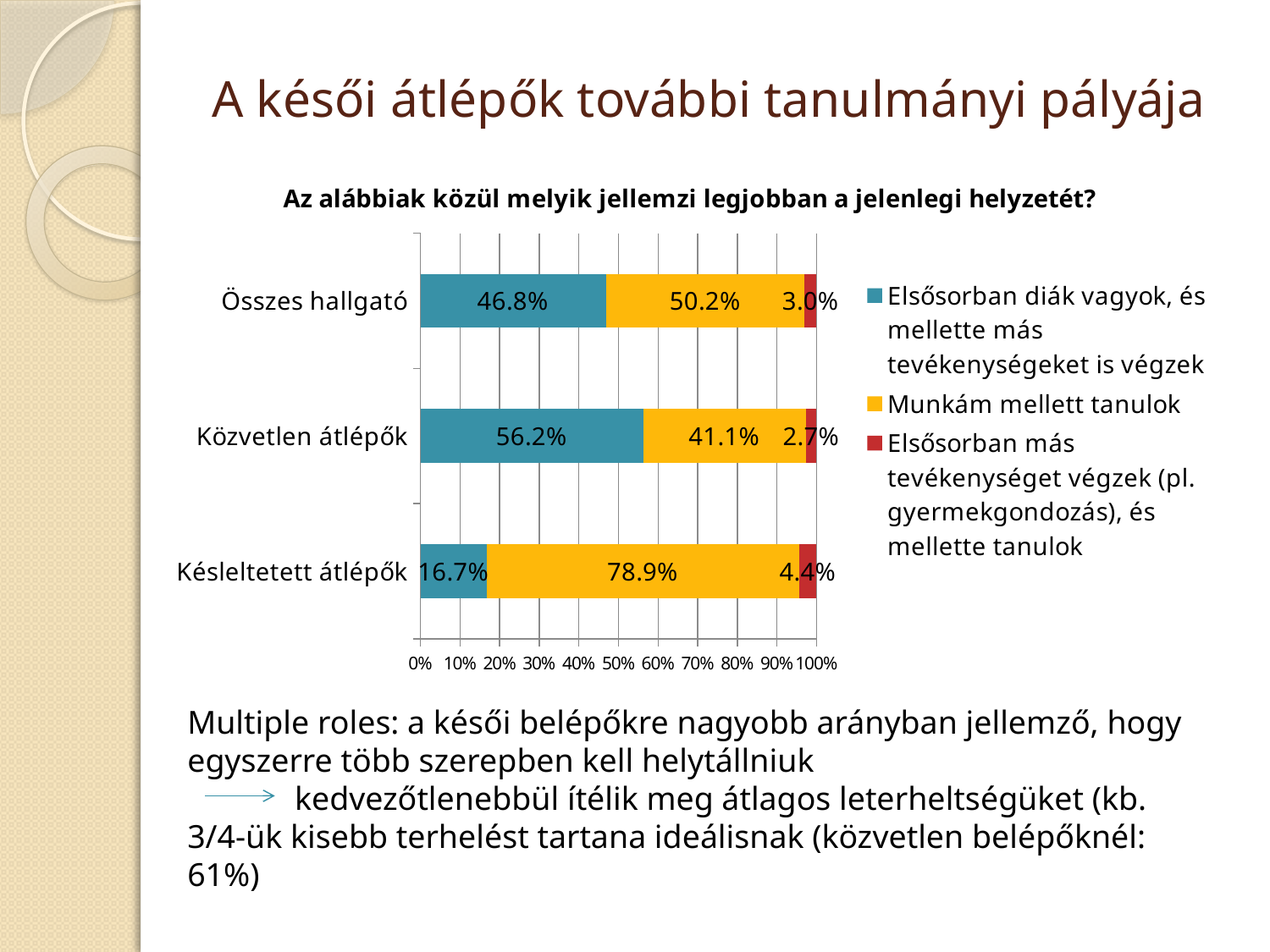
What is the value of "Elsősorban diák vagyok, és mellette más tevékenységeket is végzek" for Közvetlen átlépők? 56.2% Which series is shown in yellow? Munkám mellett tanulok Which is larger: the "Elsősorban más tevékenységet végzek" value for Késleltetett átlépők or for Közvetlen átlépők? Késleltetett átlépők What is the difference between the "Munkám mellett tanulok" values for Késleltetett átlépők and Közvetlen átlépők? 37.8% Which category has the highest value for "Munkám mellett tanulok"? Késleltetett átlépők What kind of chart is shown on the slide? stacked bar chart Which category has the lowest value for "Elsősorban diák vagyok, és mellette más tevékenységeket is végzek"? Késleltetett átlépők How many series does the legend list? 3 How many categories are shown on the vertical axis? 3 What is the chart's title? Az alábbiak közül melyik jellemzi legjobban a jelenlegi helyzetét? What is the value of "Munkám mellett tanulok" for Késleltetett átlépők? 78.9% What is the value of "Elsősorban más tevékenységet végzek (pl. gyermekgondozás), és mellette tanulok" for Összes hallgató? 3.0%